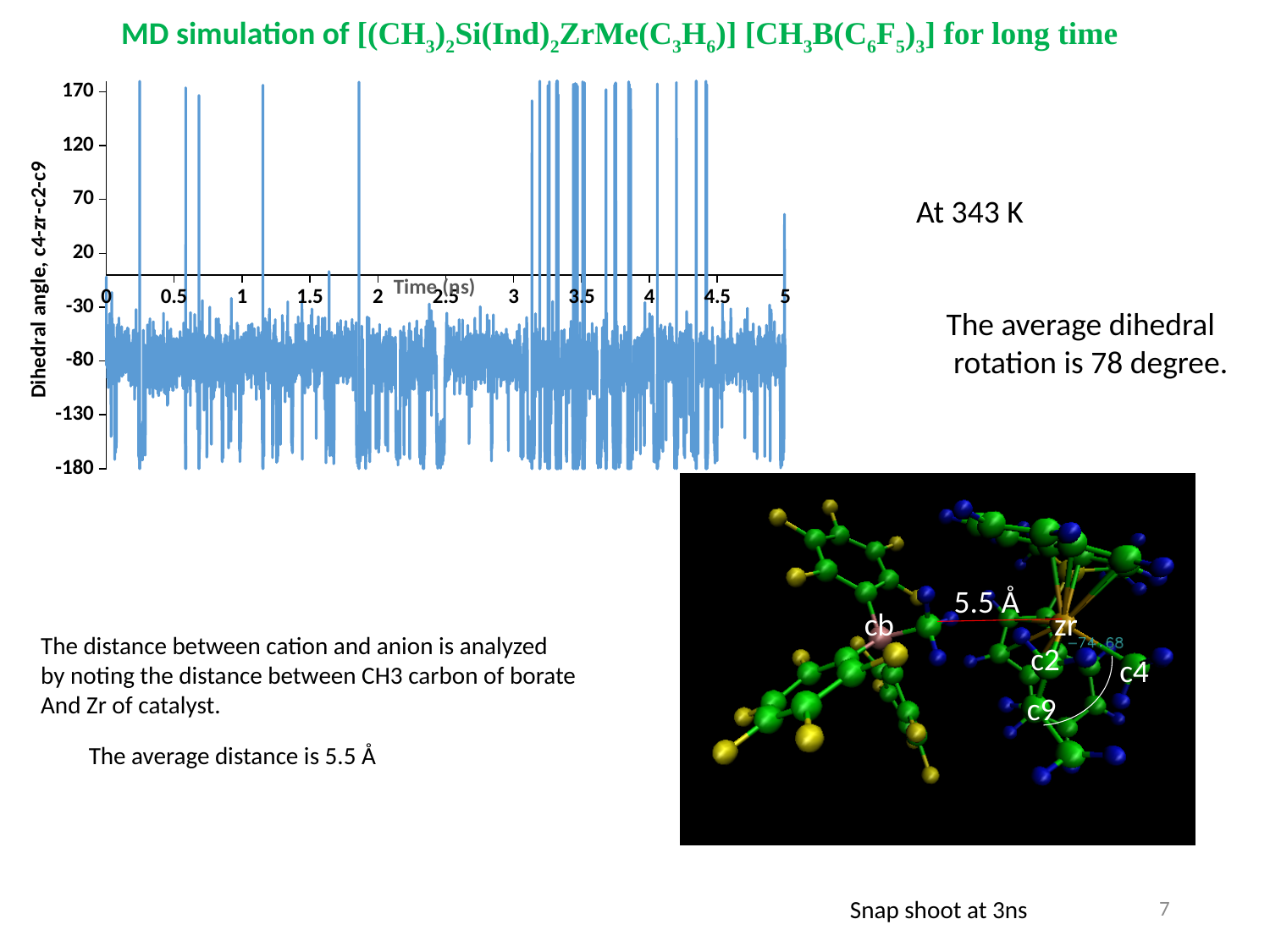
Is the dihedral angle for most of the simulation time greater or less than 20? less Is the highest value reached by the line in the chart greater or less than 120? greater What is the label of the vertical axis of the chart? Dihedral angle, c4-zr-c2-c9 What is the label of the horizontal axis of the chart? Time (ns) What kind of chart is shown on the slide? line chart Is the dihedral angle for most of the simulation time greater or less than -130? greater